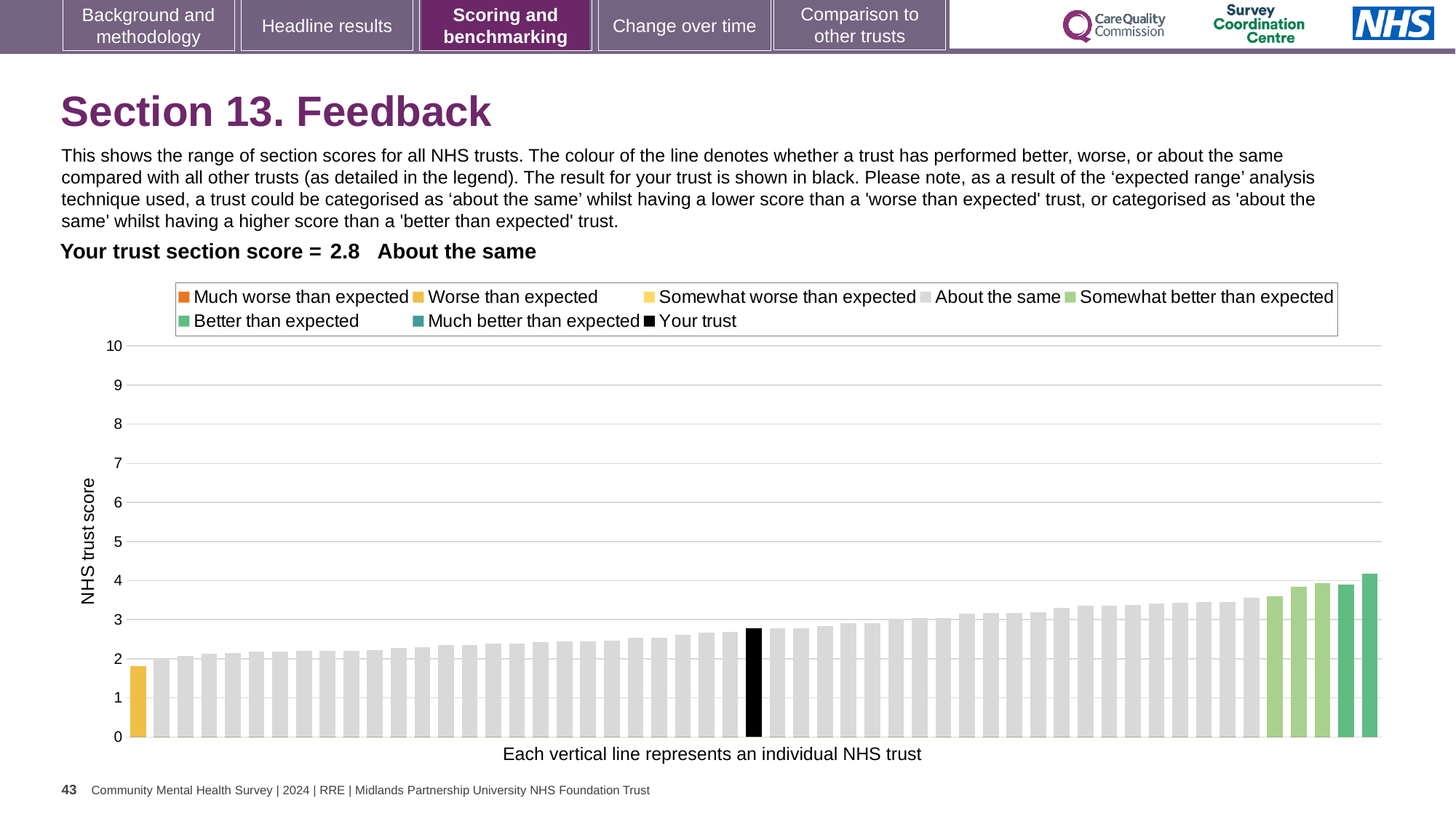
Is the value for your trust (the black bar) greater or less than 2? greater How many entries does the chart legend list? 8 What is the label of the y axis? NHS trust score Is the value of the rightmost bar greater or less than 3? greater Is the value of the shortest bar greater or less than 1? greater What colour is the bar representing your trust? black Do the bar values rise or fall from left to right along the x axis? rise How is your trust's score categorised compared with other trusts? About the same What kind of chart is shown on the slide? bar chart What is the section score for your trust shown on the slide? 2.8 What is the highest value shown on the y axis? 10